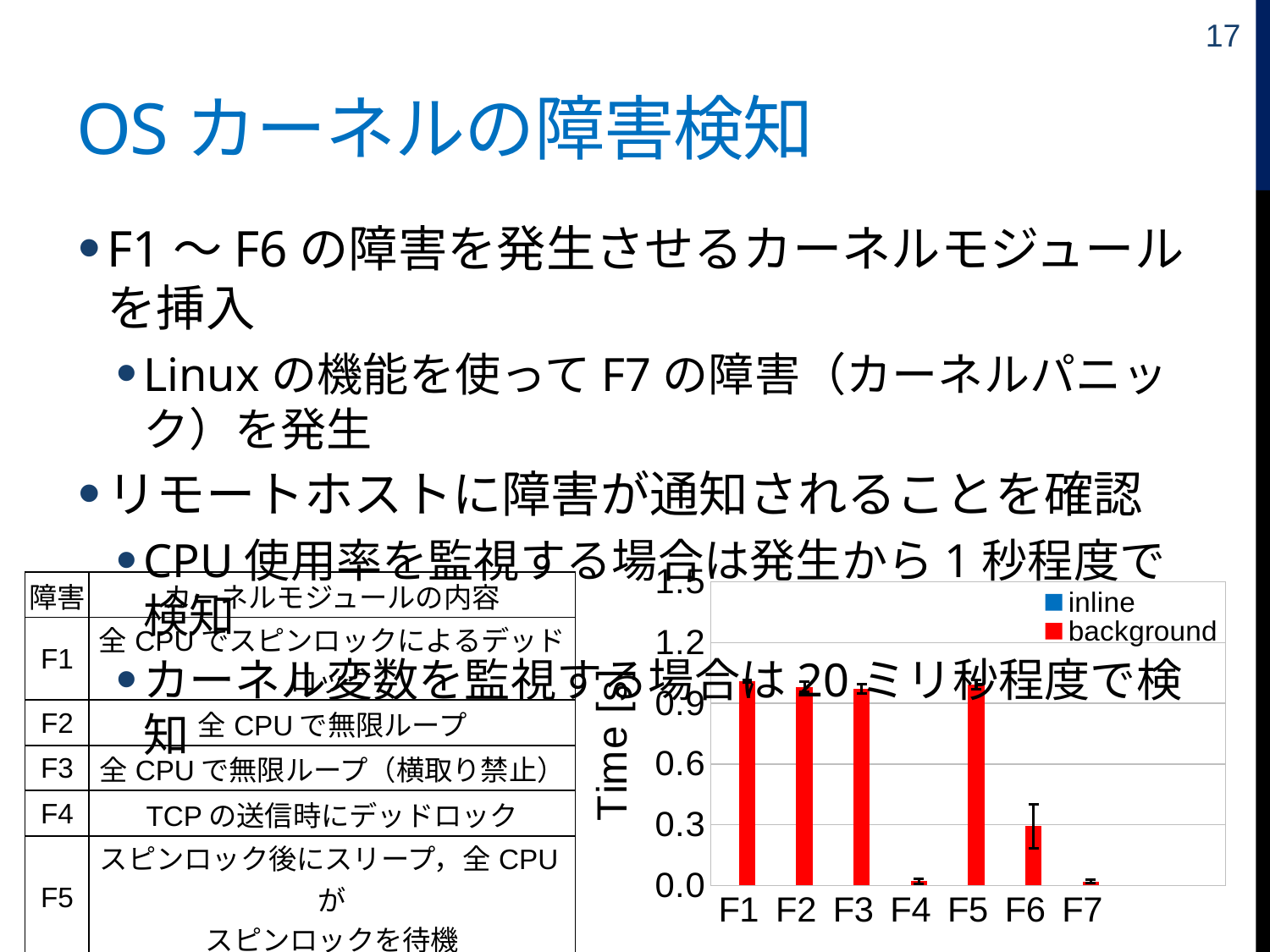
Is the background value for F7 greater or less than 0.3? less Is the background value for F5 greater or less than 0.6? greater Is the background value for F4 greater or less than 0.3? less Which has the larger background value, F1 or F6? F1 What is the label of the y axis of the chart? Time [s] How many series does the chart legend list? 2 Which has the larger background value, F6 or F7? F6 How many categories are shown on the x axis of the chart? 7 What kind of chart is shown on the slide? bar chart What are the two series listed in the chart legend? inline, background